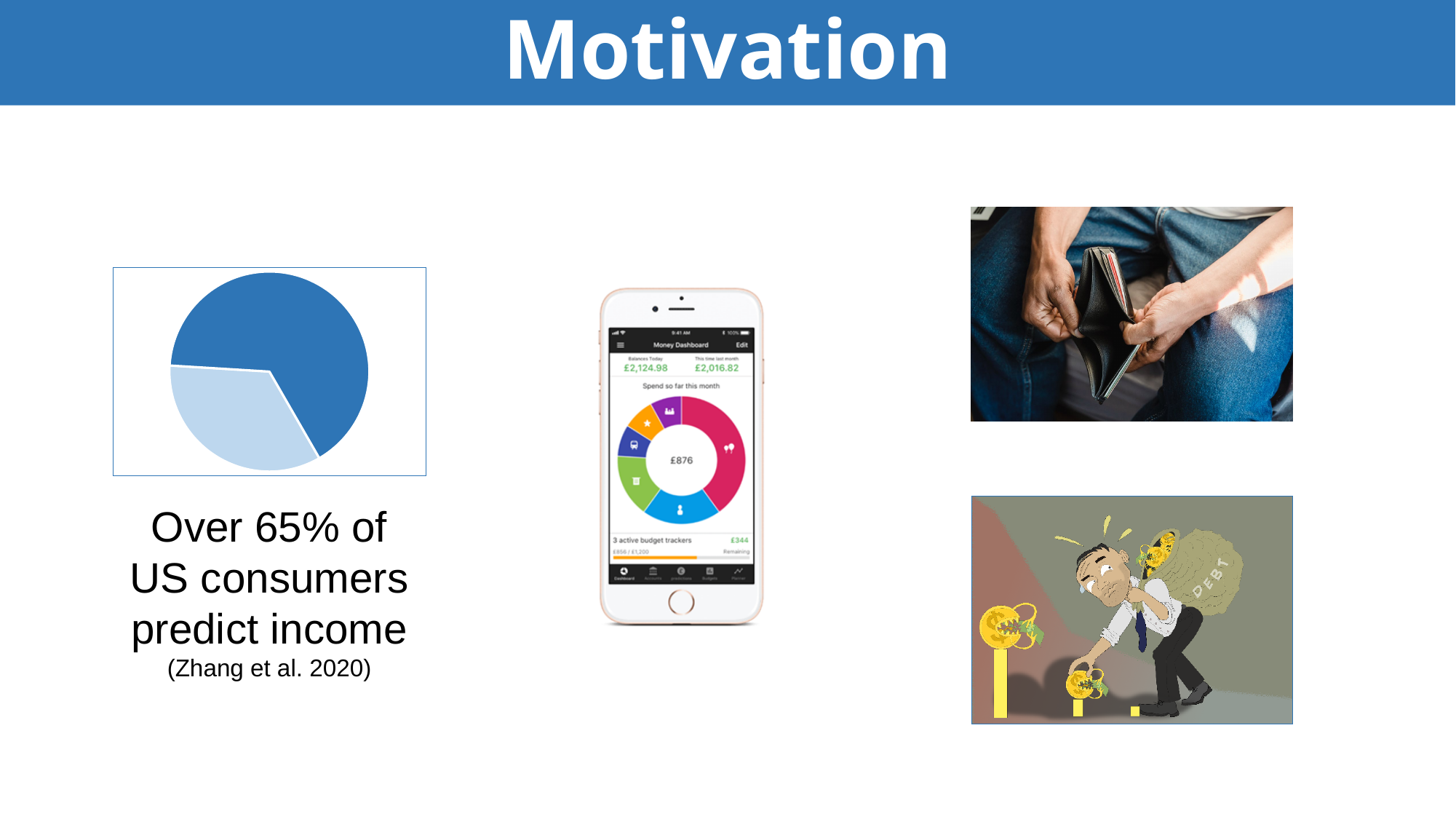
In the pie chart on the left, which slice is larger, the dark blue one or the light blue one? dark blue In the pie chart on the left, which slice is the smallest? the light blue slice Does the dark blue slice of the pie chart on the left cover more or less than half of the pie? more What kind of chart is shown on the left of the slide? pie chart Does the pie chart on the left have a legend? No What colour is the larger slice of the pie chart on the left? dark blue How many slices does the pie chart on the left have? 2